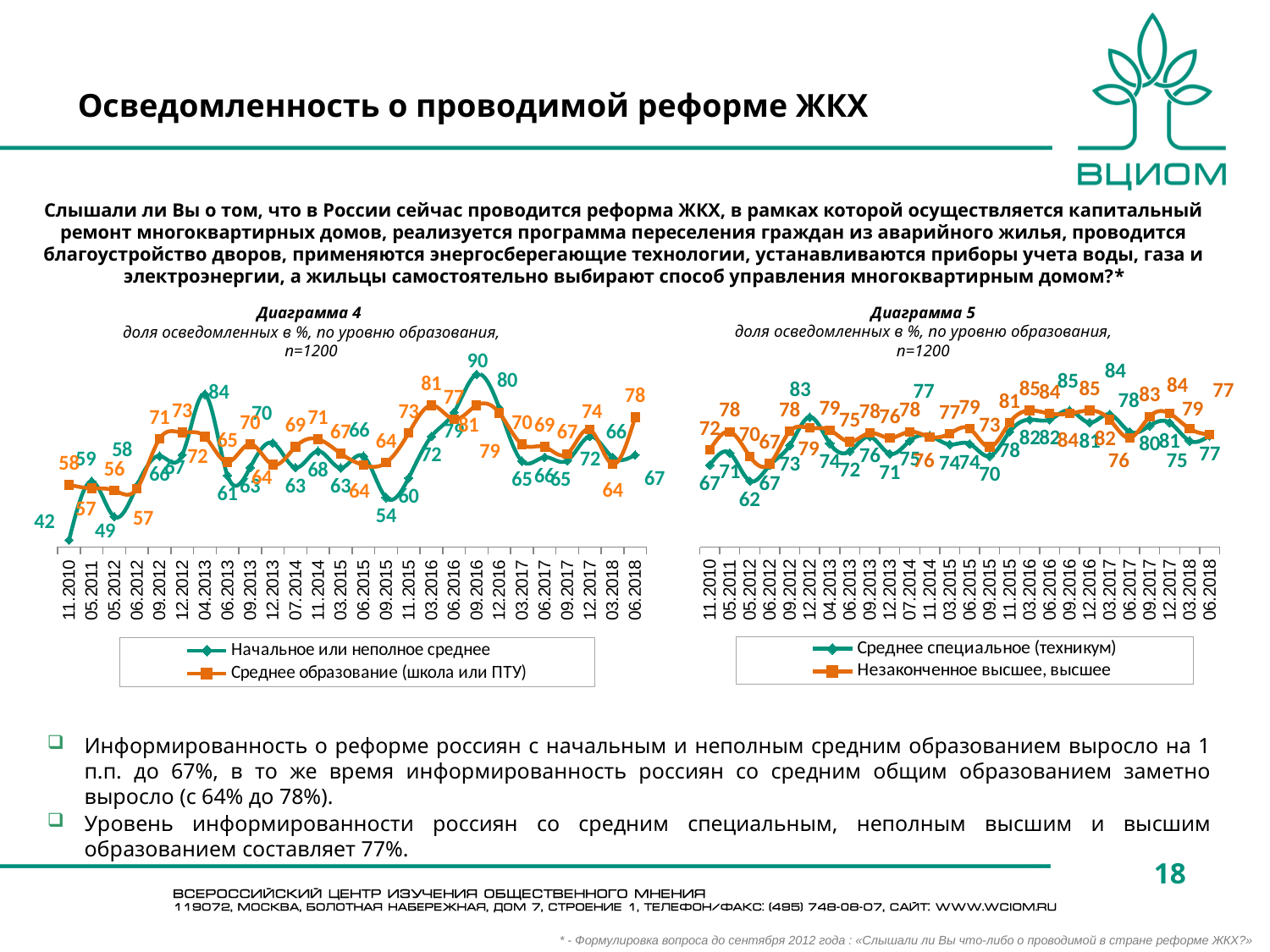
In Диаграмма 4, at which date does 'Начальное или неполное среднее' reach its highest value? 09.2016 In Диаграмма 4, what is the value for 'Среднее образование (школа или ПТУ)' at 06.2018? 78 How many time points are plotted along the x axis of Диаграмма 5? 26 In Диаграмма 4, what is the difference between the two series at 06.2018? 11 How many series does the legend of Диаграмма 5 list? 2 In Диаграмма 4, what is the lowest value of 'Среднее образование (школа или ПТУ)'? 56 In Диаграмма 5, what is the lowest value of 'Среднее специальное (техникум)'? 62 In Диаграмма 4, does 'Среднее образование (школа или ПТУ)' rise or fall between 03.2018 and 06.2018? rise What kind of chart is Диаграмма 4? line chart In Диаграмма 5, which series has the higher value at 03.2016? Незаконченное высшее, высшее In Диаграмма 4, what is the value for 'Начальное или неполное среднее' at 11.2010? 42 In Диаграмма 5, what is the value for 'Незаконченное высшее, высшее' at 12.2012? 79